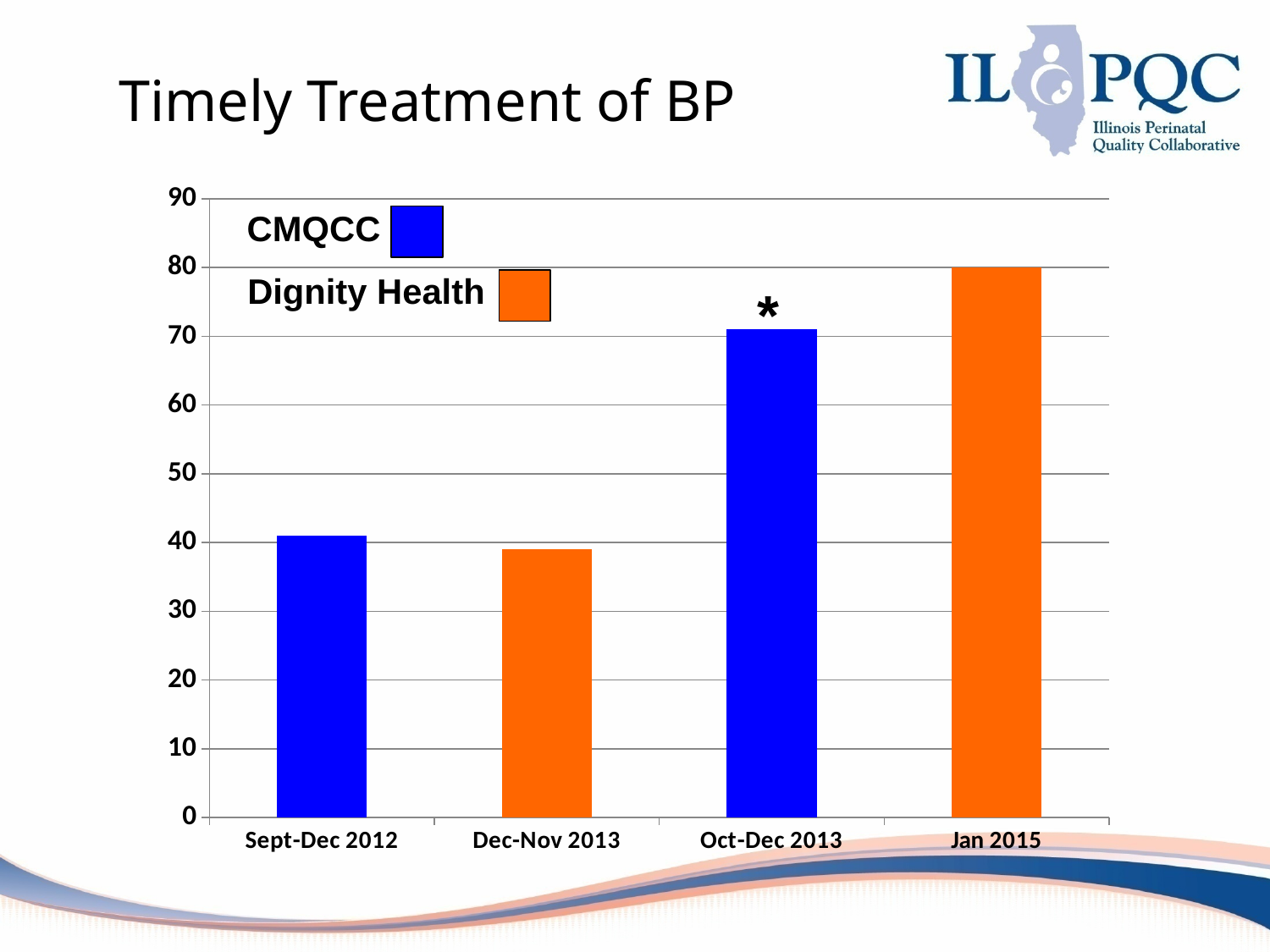
Which is larger, the value for Oct-Dec 2013 or the value for Sept-Dec 2012? Oct-Dec 2013 What is the title of the slide? Timely Treatment of BP Which series is shown in orange? Dignity Health How many series does the legend list? 2 Is the value for Jan 2015 greater or less than 70? greater How many categories are shown on the x axis? 4 Which category has the lowest bar? Dec-Nov 2013 Which category has the highest bar? Jan 2015 Is the value for Sept-Dec 2012 greater or less than 50? less What kind of chart is shown on the slide? bar chart